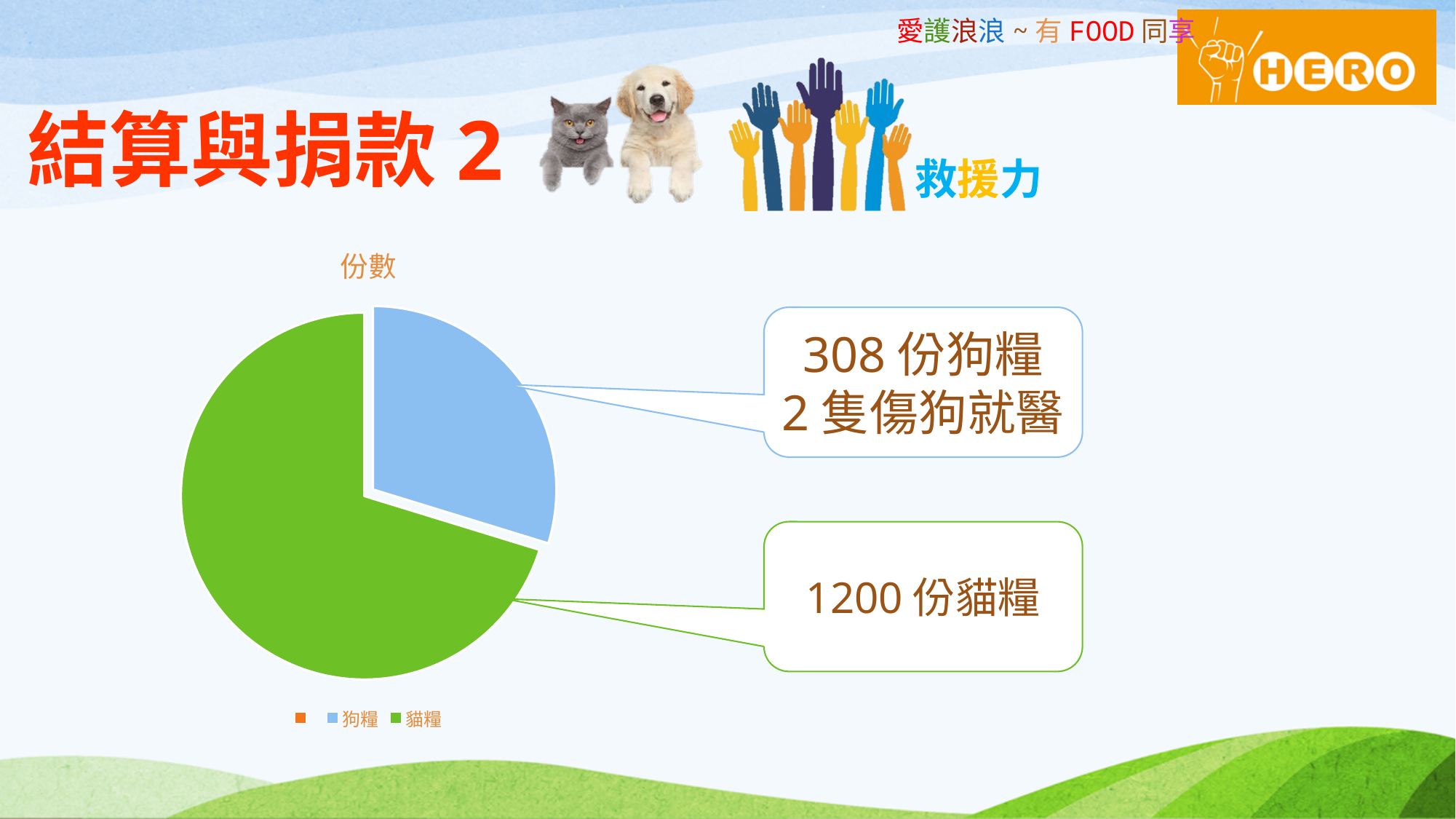
Which is larger, the value for 狗糧 or the value for 貓糧? 貓糧 Which category has the largest slice in the pie chart? 貓糧 What kind of chart is shown on the slide? pie chart What is the title of the pie chart? 份數 How many 份 of 貓糧 does the pie chart show? 1200 What colour is the 貓糧 slice in the pie chart? green How many slices are visible in the pie chart? 2 Which category has the smallest slice in the pie chart? 狗糧